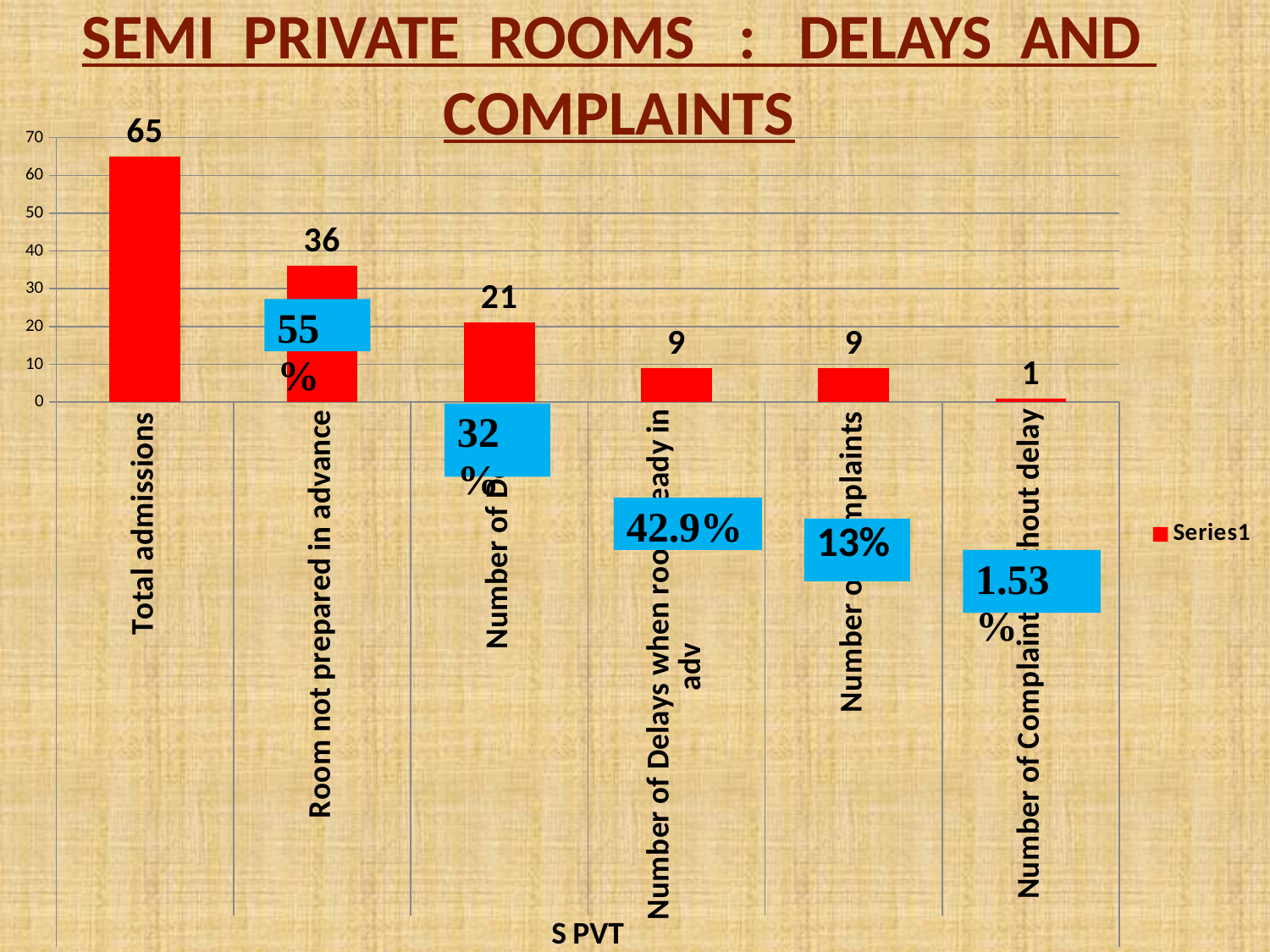
What kind of chart is shown on the slide? bar chart What is the value for Total admissions? 65 Is the value for Room not prepared in advance greater or less than 30? greater What is the value for Room not prepared in advance? 36 Which is larger, Total admissions or Room not prepared in advance? Total admissions What is the difference between Total admissions and Room not prepared in advance? 29 What is the title of the chart? SEMI PRIVATE ROOMS : DELAYS AND COMPLAINTS How many series does the legend list? 1 What is the value for Number of Complaint without delay? 1 How many bars are plotted in the chart? 6 Which category has the highest value? Total admissions Which category has the lowest value? Number of Complaint without delay